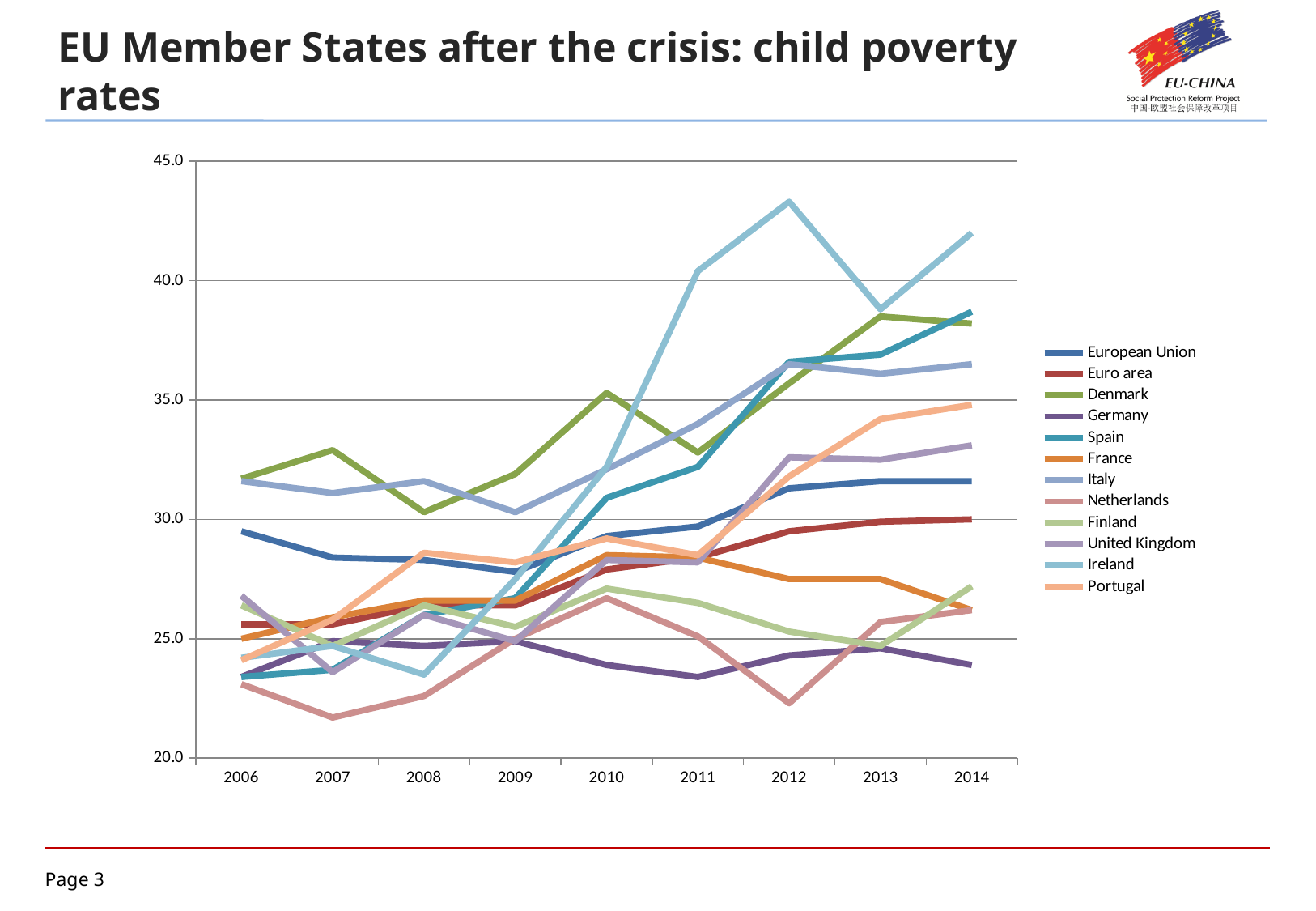
Does the value for Spain rise or fall from 2006 to 2014? rise What kind of chart is shown on the slide? line chart Is the value for Ireland in 2012 greater or less than 40.0? greater How many series does the legend list? 12 Which series has the lowest value in 2014? Germany Which series has the highest value in 2012? Ireland How many years are shown on the x axis? 9 What is the title of the slide containing the chart? EU Member States after the crisis: child poverty rates Is the value for Germany in 2014 greater or less than 25.0? less Is the value for Denmark in 2014 greater or less than 35.0? greater Which series has the lowest value in 2007? Netherlands Which is larger in 2014, the value for Spain or the value for Germany? Spain